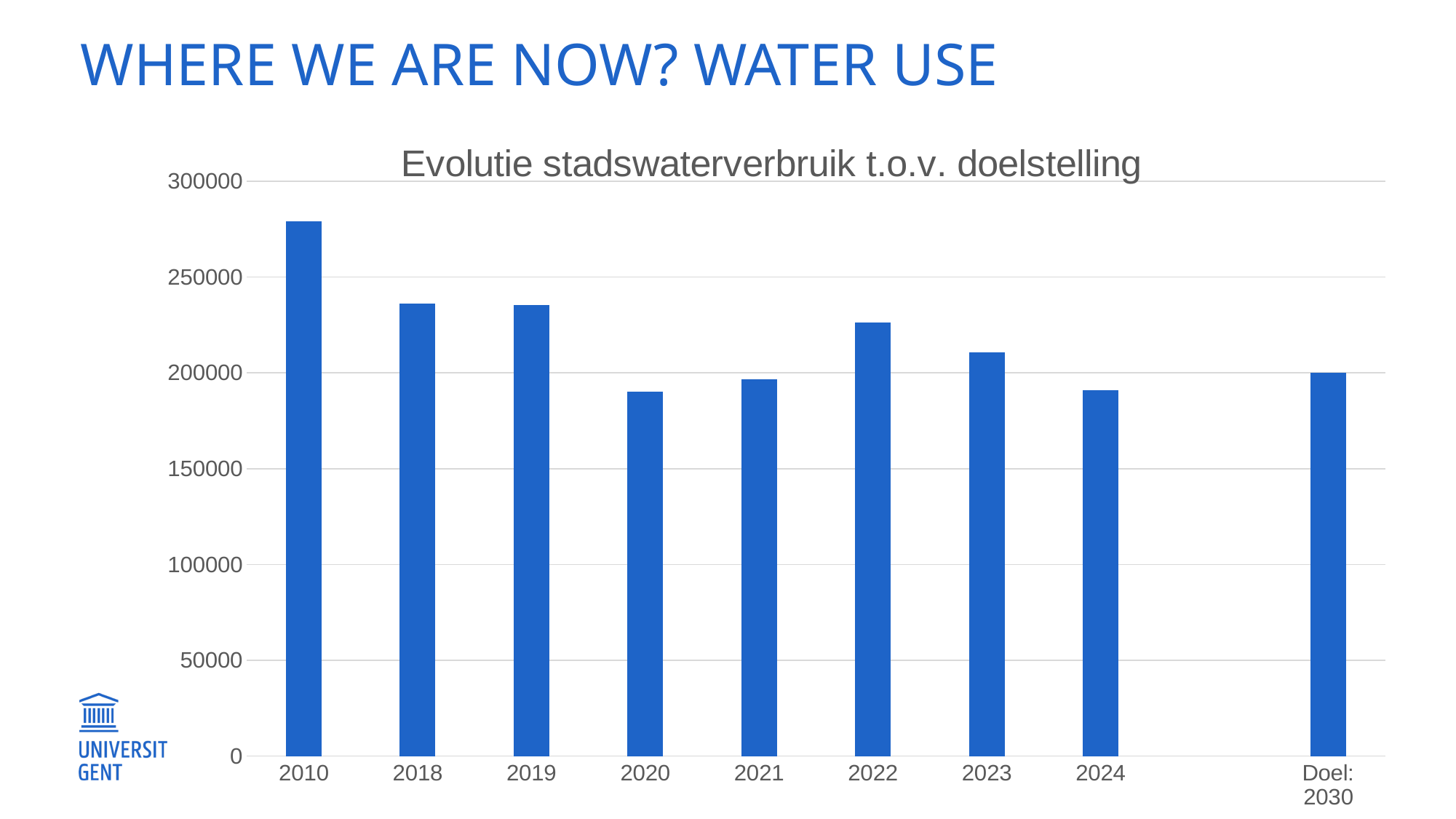
How many bars are plotted in the chart? 9 Is the value for 2018 greater or less than 250000? less What kind of chart is shown on the slide? Bar chart Is the value for 2022 greater or less than 200000? greater Which is larger, the value for 2022 or the value for 2023? 2022 What is the title of the chart? Evolutie stadswaterverbruik t.o.v. doelstelling Is the value for 2010 greater or less than 250000? greater Which is larger, the value for 2010 or the value for 2018? 2010 Which category has the highest value? 2010 Do the values rise or fall from 2018 to 2020? fall